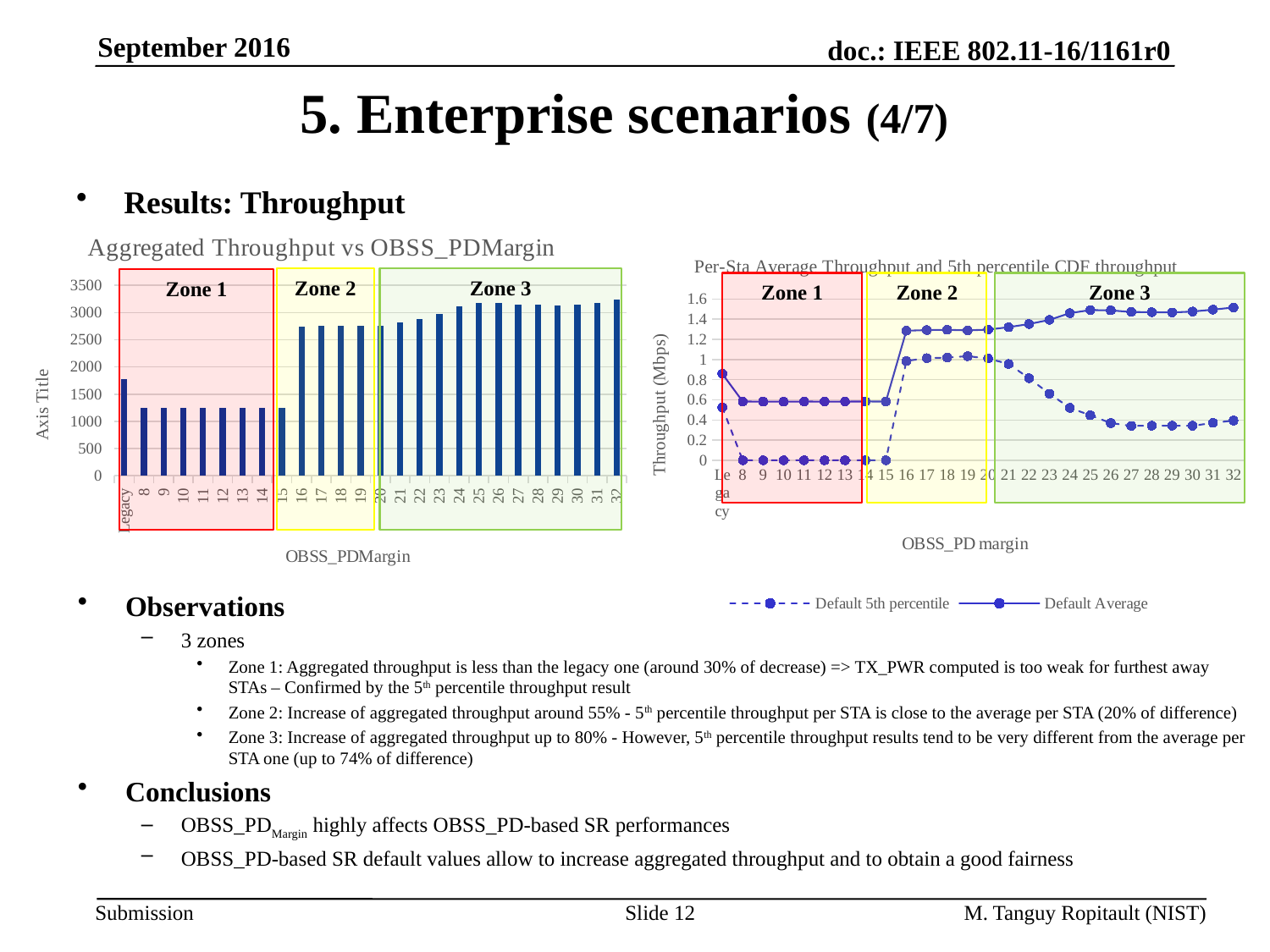
In the right chart, is the Default Average value at 16 greater or less than 1.2? greater In the right chart, is the Default 5th percentile value at 8 greater or less than 0.2? less What kind of chart is the 'Per-Sta Average Throughput and 5th percentile CDF throughput' chart on the right? line chart How many categories are shown on the x axis of the left 'Aggregated Throughput vs OBSS_PDMargin' chart? 26 What kind of chart is the 'Aggregated Throughput vs OBSS_PDMargin' chart on the left? bar chart In the right chart, which series has the larger value at 32, Default Average or Default 5th percentile? Default Average What is the y-axis title of the right chart? Throughput (Mbps) How many series does the legend of the right chart list? 2 In the left 'Aggregated Throughput vs OBSS_PDMargin' chart, is the value for Legacy greater or less than 1500? greater In the left 'Aggregated Throughput vs OBSS_PDMargin' chart, which is larger, the value for Legacy or the value for 10? Legacy